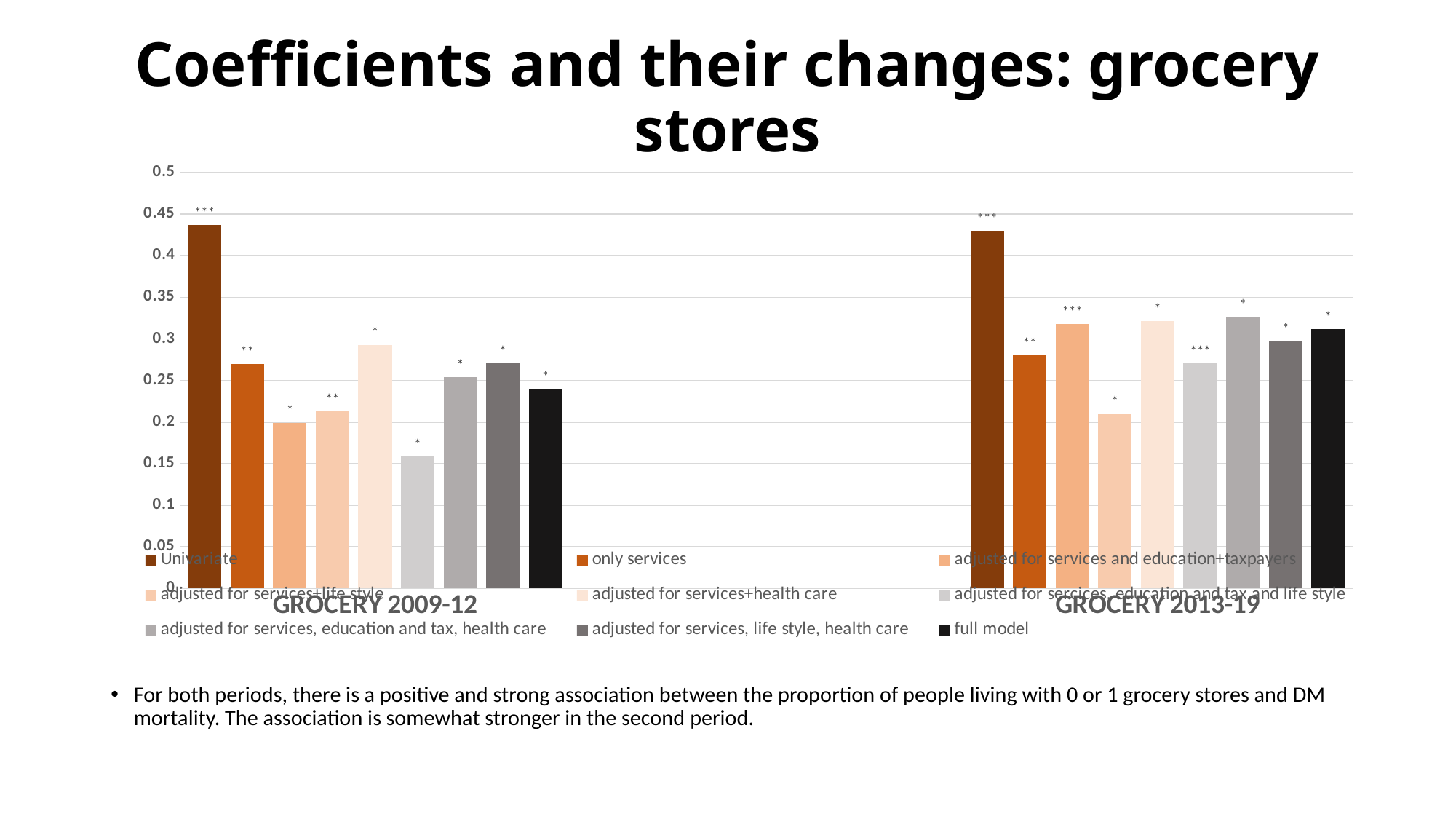
Which series has the highest value for GROCERY 2009-12? Univariate What colour are the bars for the 'full model' series? black How many categories are shown on the x axis of the chart? 2 Is the full model value larger for GROCERY 2009-12 or for GROCERY 2013-19? GROCERY 2013-19 Is the value for 'adjusted for services, education and tax and life style' for GROCERY 2009-12 greater or less than 0.2? less What kind of chart is shown on the slide? bar chart Which series has the lowest value for GROCERY 2009-12? adjusted for services, education and tax and life style Which series has the lowest value for GROCERY 2013-19? adjusted for services+life style Is the value for 'adjusted for services and education+taxpayers' larger for GROCERY 2009-12 or for GROCERY 2013-19? GROCERY 2013-19 How many series does the chart's legend list? 9 Which series has the highest value for GROCERY 2013-19? Univariate Is the Univariate value for GROCERY 2009-12 greater or less than 0.4? greater